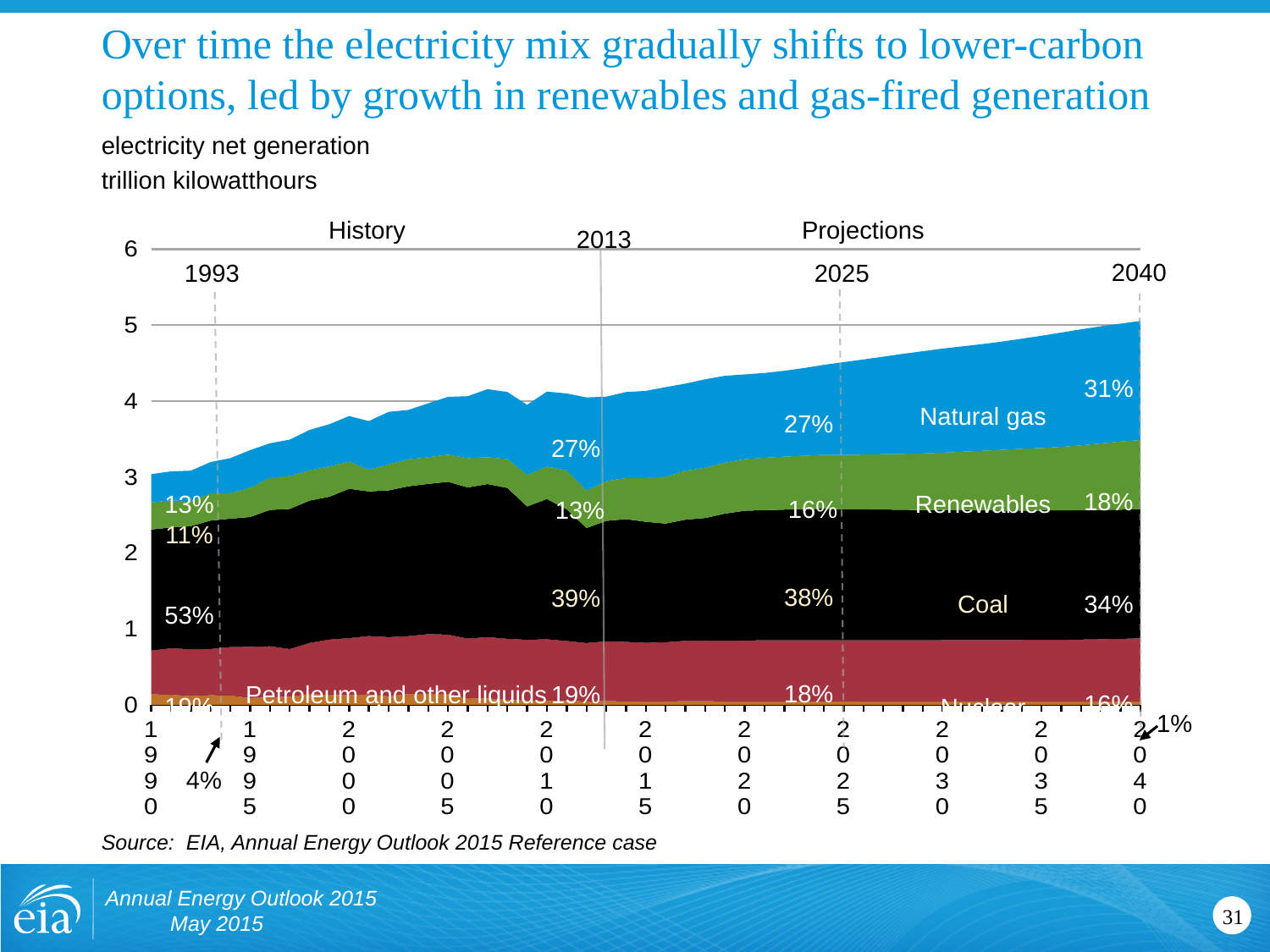
What share of electricity net generation do petroleum and other liquids account for in 2040? 1% What share of electricity net generation do renewables account for in 2025? 16% By how many percentage points does the renewables share of generation rise between 1993 and 2040? 7 percentage points Is total electricity net generation in 2025 greater or less than 4 trillion kilowatthours? greater What kind of chart is shown on the slide? Stacked area chart What share of electricity net generation does natural gas account for in 2040? 31% What share of electricity net generation does coal account for in 1993? 53% By how many percentage points does coal's share of generation fall between 1993 and 2040? 19 percentage points Which year separates the History and Projections sections of the chart? 2013 What share of electricity net generation does natural gas account for in 2013? 27% Does the natural gas share of generation rise or fall between 1993 and 2040? Rise In 2040, which has the larger share of generation, coal or natural gas? Coal